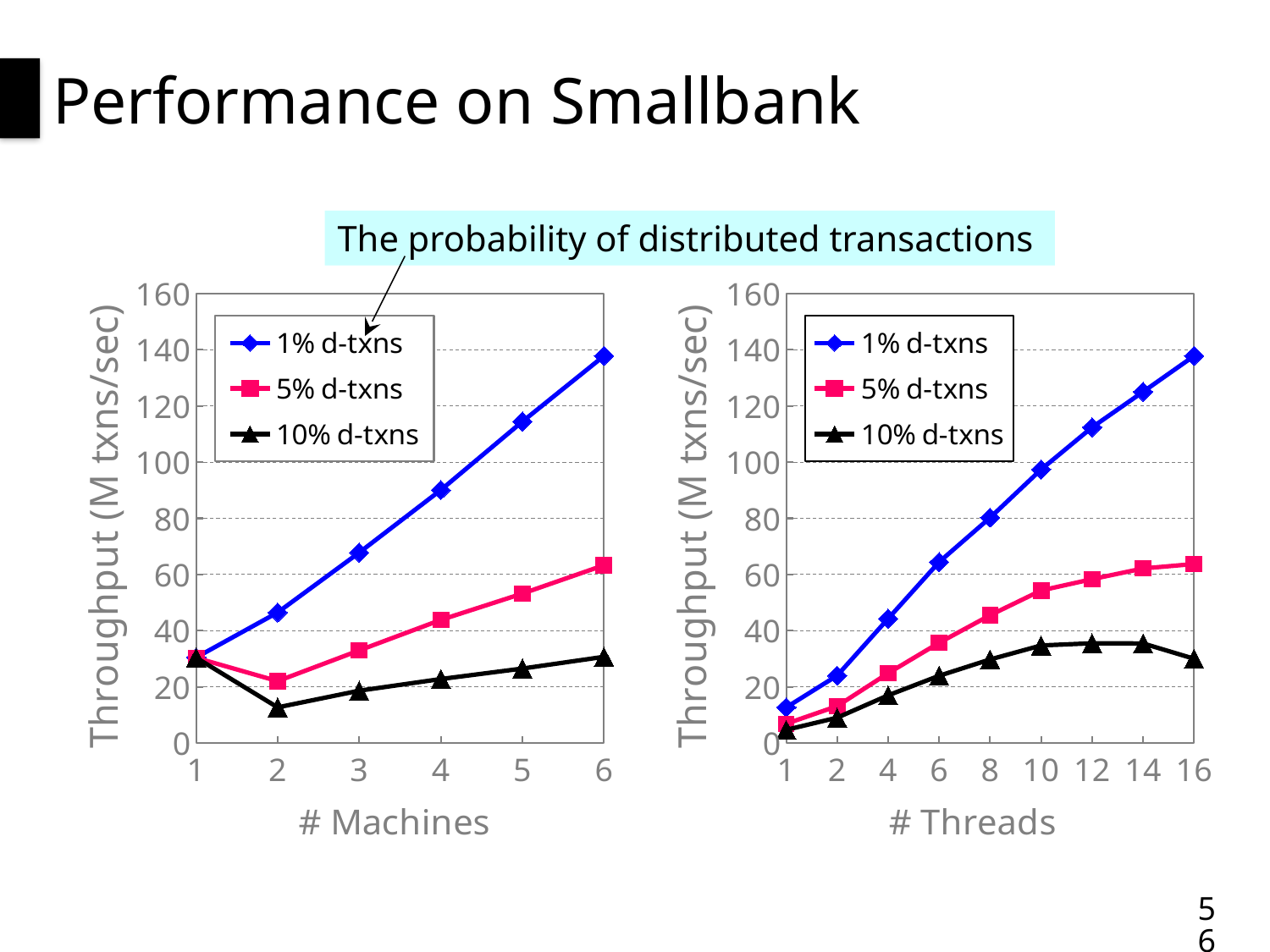
What is the x-axis label of the right chart? # Threads How many x-axis points are plotted on the right chart (# Threads)? 9 How many x-axis points are plotted on the left chart (# Machines)? 6 On the left chart (# Machines), is the value for 1% d-txns at 6 machines greater or less than 120? greater On the right chart (# Threads), is the value for 10% d-txns at 16 threads greater or less than 40? less How many series does the legend of the right chart (# Threads) list? 3 On the right chart (# Threads), which series has the lowest throughput at 16 threads? 10% d-txns On the right chart (# Threads), is the value for 1% d-txns at 10 threads greater or less than 80? greater What kind of chart is the left chart (# Machines)? line chart On the left chart (# Machines), which series has the highest throughput at 6 machines? 1% d-txns On the left chart (# Machines), does the throughput for 1% d-txns rise or fall as the number of machines increases? rise